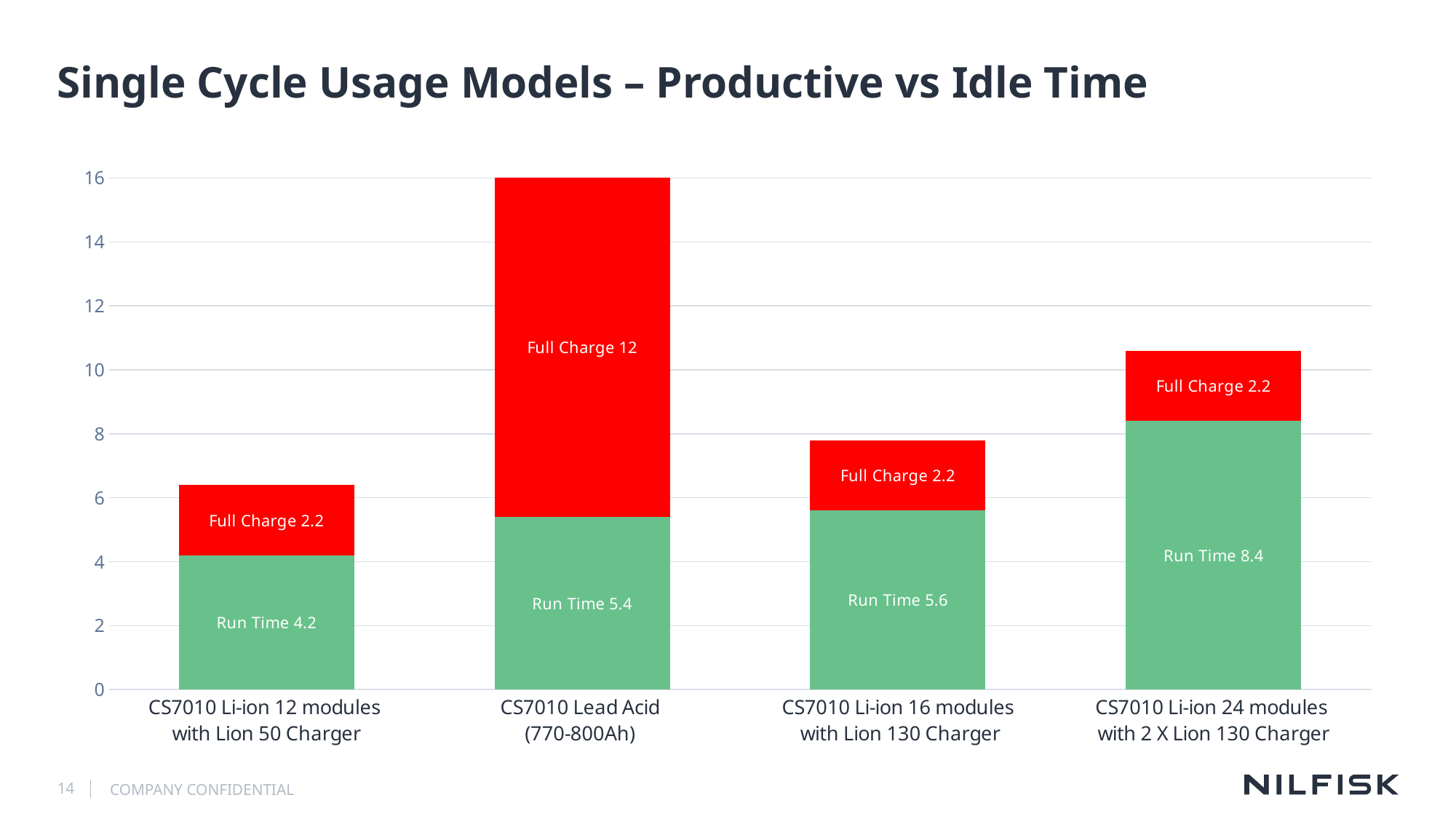
What is the total of the stacked bar for CS7010 Lead Acid (770-800Ah)? 17.4 What is the Full Charge value for CS7010 Lead Acid (770-800Ah)? 12 Which category has the highest Run Time? CS7010 Li-ion 24 modules with 2 X Lion 130 Charger Which category has the highest Full Charge value? CS7010 Lead Acid (770-800Ah) What kind of chart is shown on the slide? Stacked bar chart What is the total of the stacked bar for CS7010 Li-ion 16 modules with Lion 130 Charger? 7.8 What is the Run Time value for CS7010 Li-ion 24 modules with 2 X Lion 130 Charger? 8.4 Which category has the lowest Run Time? CS7010 Li-ion 12 modules with Lion 50 Charger What is the Full Charge value for CS7010 Li-ion 16 modules with Lion 130 Charger? 2.2 What is the Run Time value for CS7010 Li-ion 12 modules with Lion 50 Charger? 4.2 What is the difference between the Run Time of CS7010 Li-ion 24 modules with 2 X Lion 130 Charger and CS7010 Li-ion 12 modules with Lion 50 Charger? 4.2 How many categories are shown on the x axis? 4